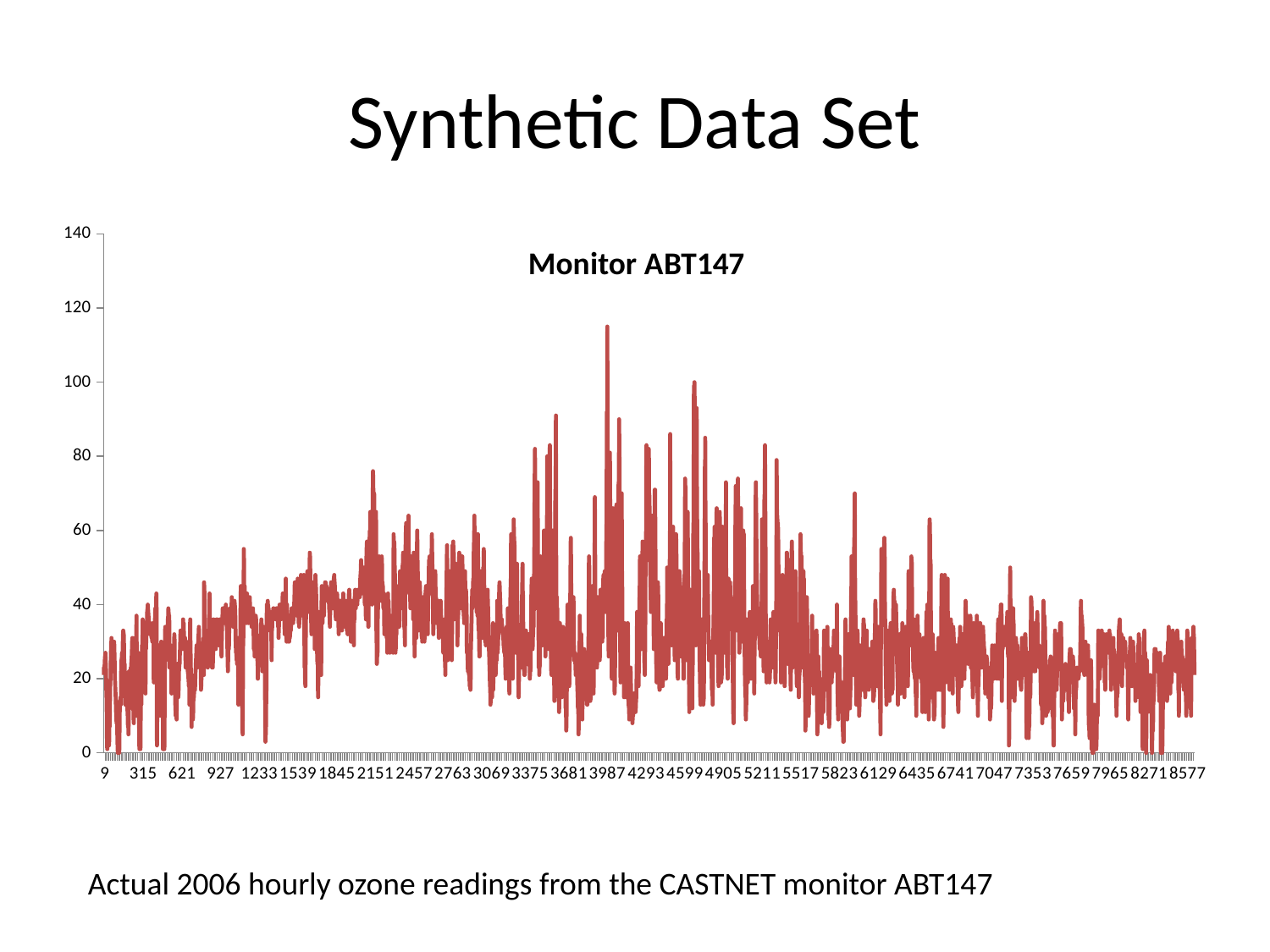
What is the last label on the horizontal axis? 8577 Is the highest peak of the line greater or less than 120? less Is the highest peak of the line greater or less than 100? greater What is the first label on the horizontal axis? 9 What is the highest value shown on the vertical axis? 140 Is the value at the last x-axis label (8577) greater or less than 80? less What kind of chart is shown on the slide? line chart Roughly where along the x axis does the highest peak occur: near the start, near the middle, or near the end? near the middle What is the title of the chart? Monitor ABT147